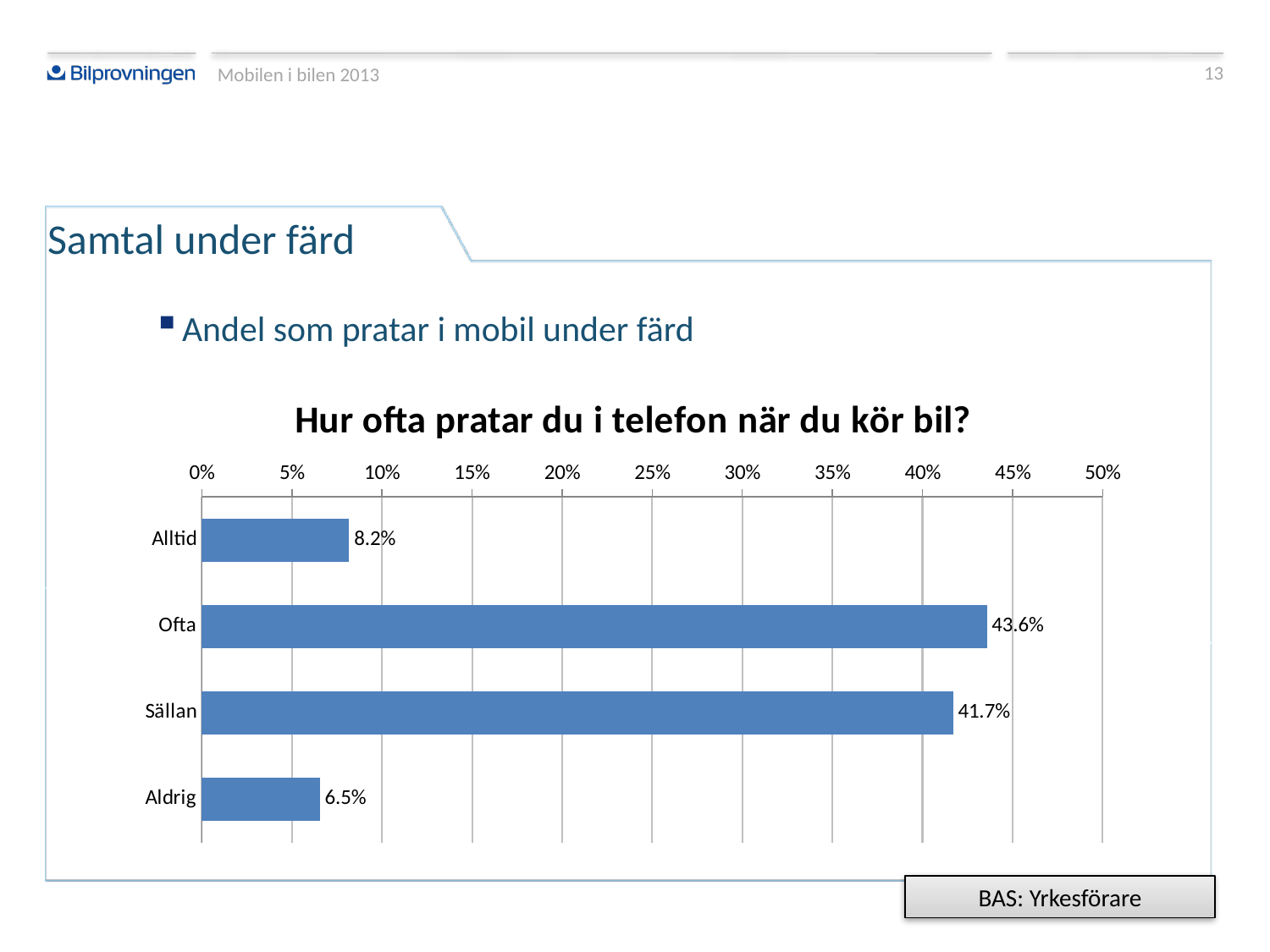
Which category has the highest value? Ofta What is the value for Sällan? 41.7% What is the value for Alltid? 8.2% How many categories are shown in the chart? 4 What is the difference between the values for Ofta and Sällan? 1.9% What is the value for Aldrig? 6.5% Is the value for Sällan greater or less than 40%? greater Which is larger, the value for Alltid or the value for Aldrig? Alltid Which category has the lowest value? Aldrig What is the value for Ofta? 43.6% What is the difference between the values for Alltid and Aldrig? 1.7% What kind of chart is shown on the slide? Bar chart